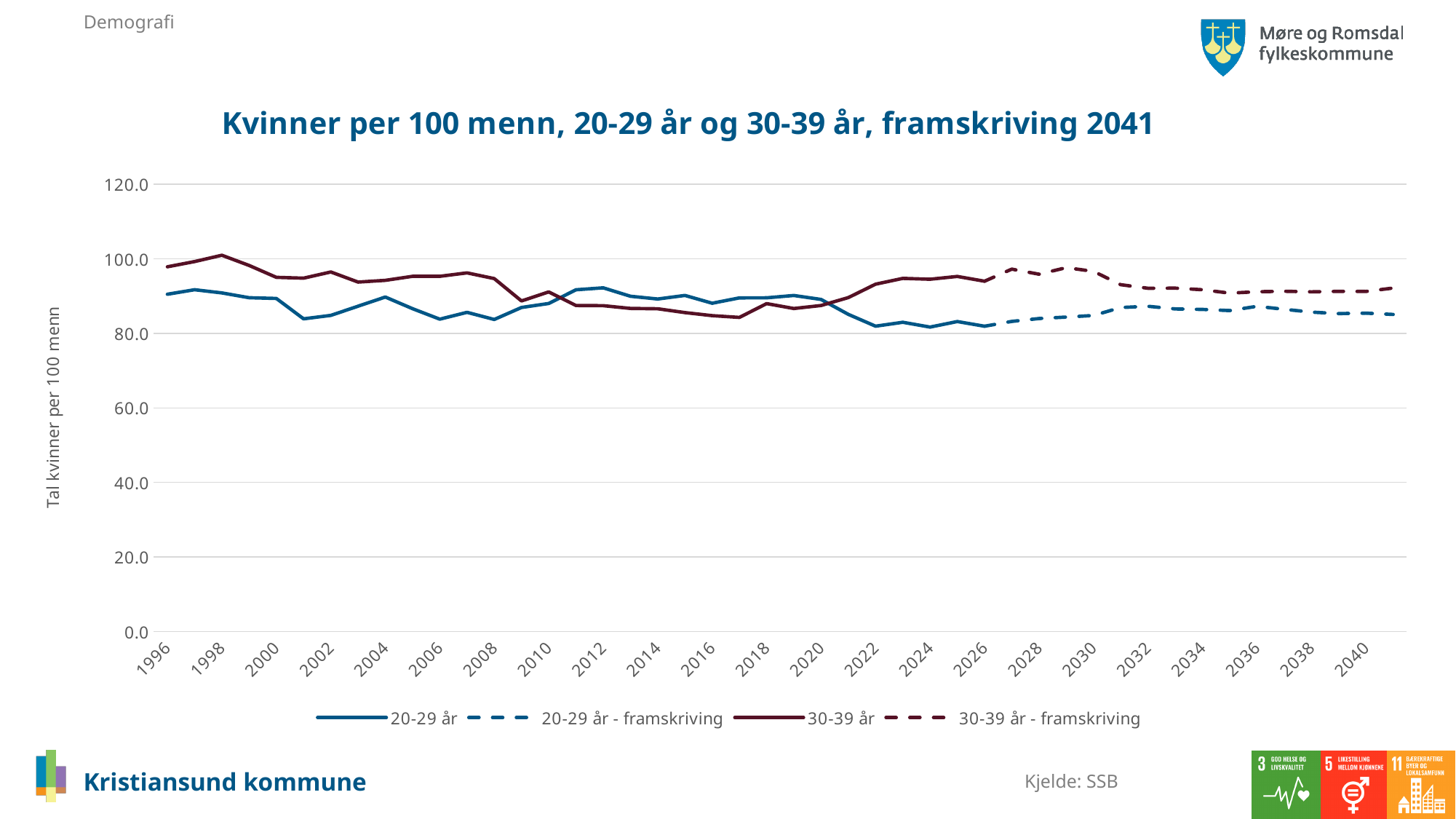
In 2012, which series has the higher value, 20-29 år or 30-39 år? 20-29 år What kind of chart is shown on the slide? Line chart How many series does the chart legend list? 4 What is the title of the chart? Kvinner per 100 menn, 20-29 år og 30-39 år, framskriving 2041 In which year does the 30-39 år series reach its highest value? 1998 Is the value for 20-29 år in 2012 greater or less than 100? less Is the value for 30-39 år in 2016 greater or less than 80? greater In 2022, which series has the higher value, 20-29 år or 30-39 år? 30-39 år What is the label on the vertical axis of the chart? Tal kvinner per 100 menn In 1996, which series has the higher value, 20-29 år or 30-39 år? 30-39 år Is the value for 30-39 år - framskriving in 2040 greater or less than 100? less Does the 20-29 år series rise or fall between 2020 and 2022? Fall